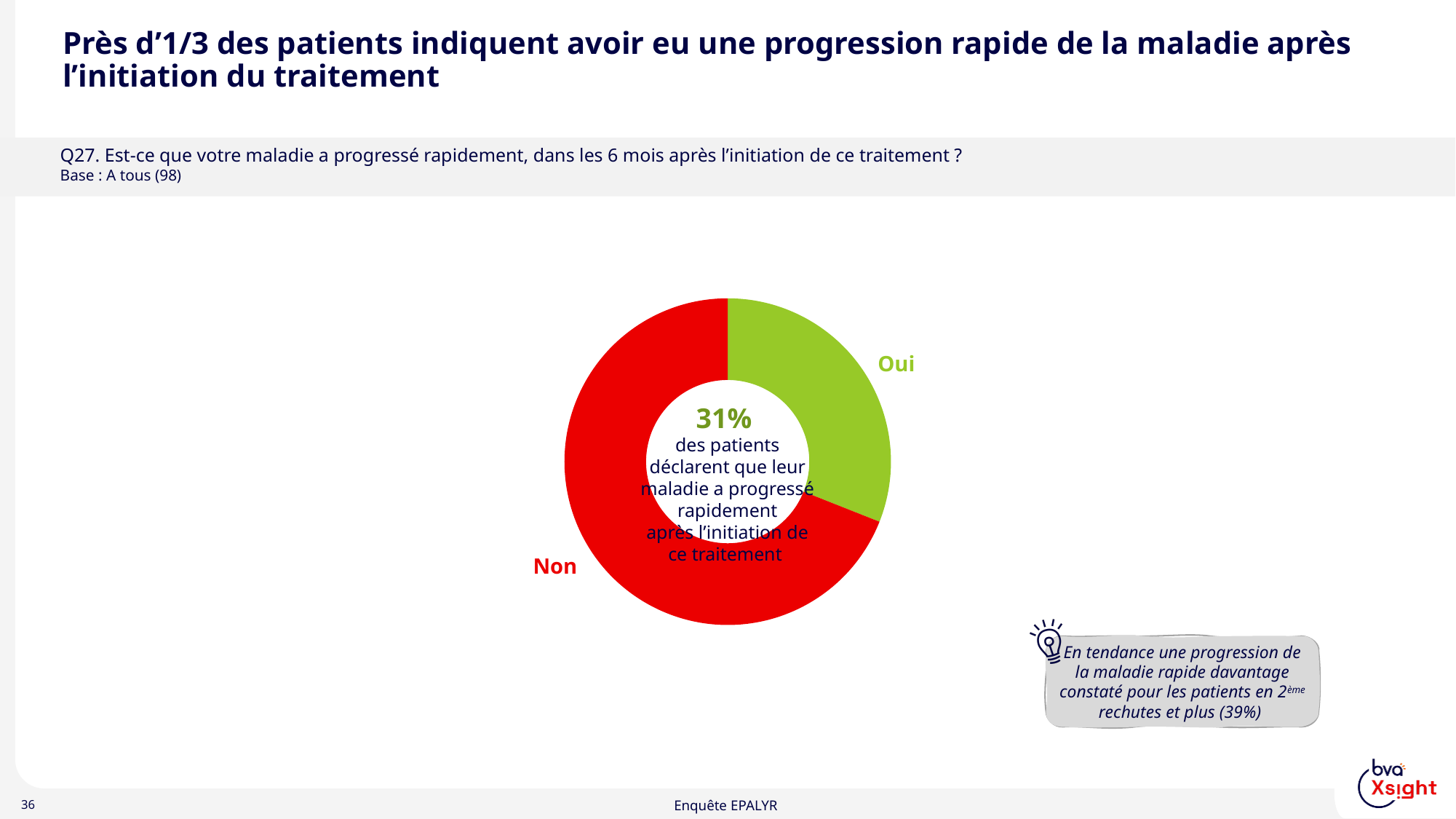
What colour is the "Oui" slice in the donut chart? Green How many categories does the donut chart show? 2 What colour is the "Non" slice in the donut chart? Red Which category has the largest slice in the donut chart? Non What percentage is printed in the centre of the donut chart? 31% What share of patients answered "Oui" in the donut chart? 31% Which slice is larger in the donut chart, "Oui" or "Non"? Non What kind of chart is shown on the slide? Pie chart (donut) Which category has the smallest slice in the donut chart? Oui